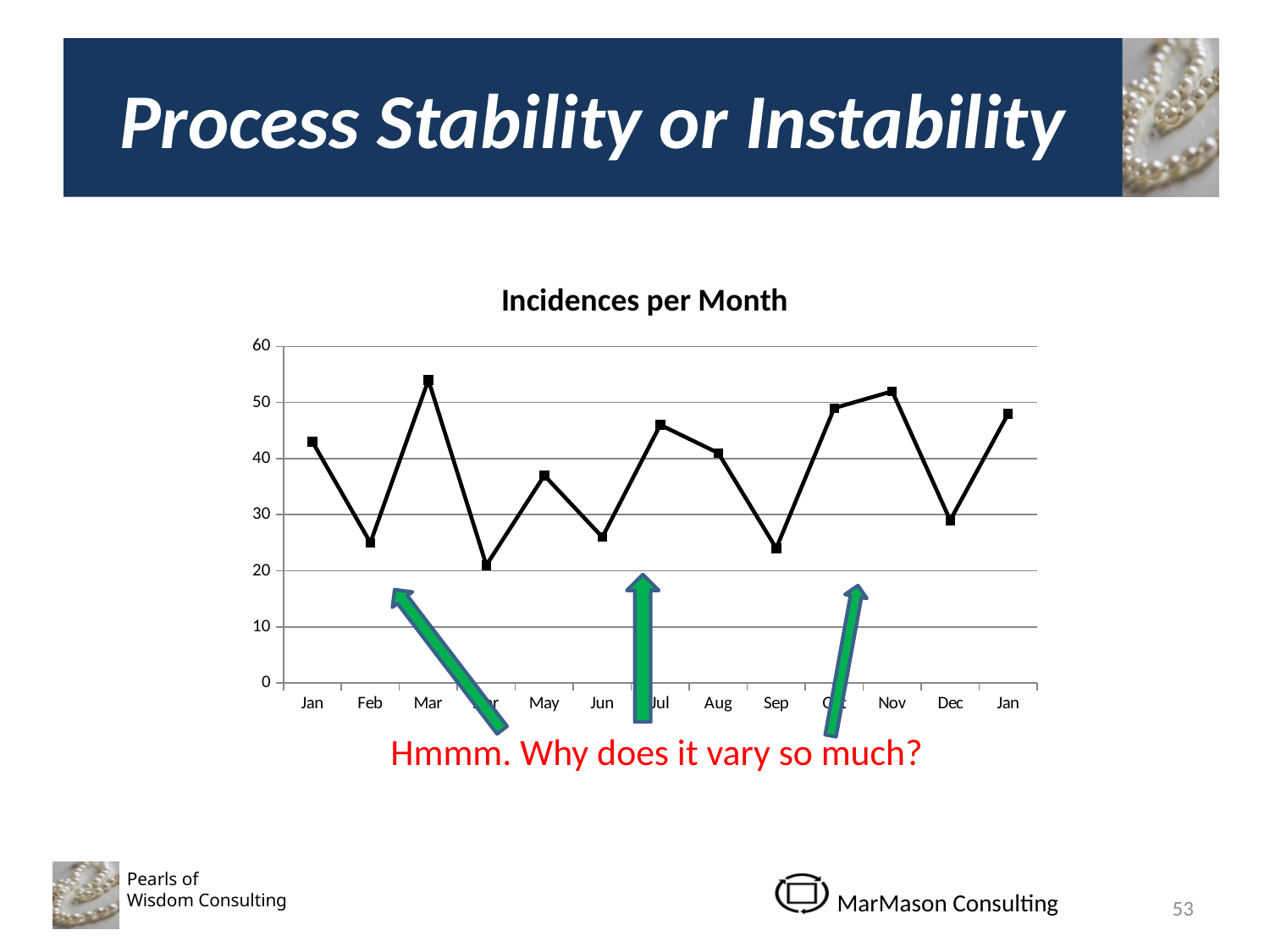
Which month has the higher value, Jul or Jun? Jul What is the highest value shown on the vertical axis? 60 Is the value for Mar greater or less than 50? greater Is the value for Sep greater or less than 30? less Which month has the higher value, Mar or Feb? Mar Is the value for Feb greater or less than 30? less How many data points are plotted on the line? 13 What type of chart is shown on the slide? line chart What is the title of the chart? Incidences per Month Does the value rise or fall from Jan to Feb? fall